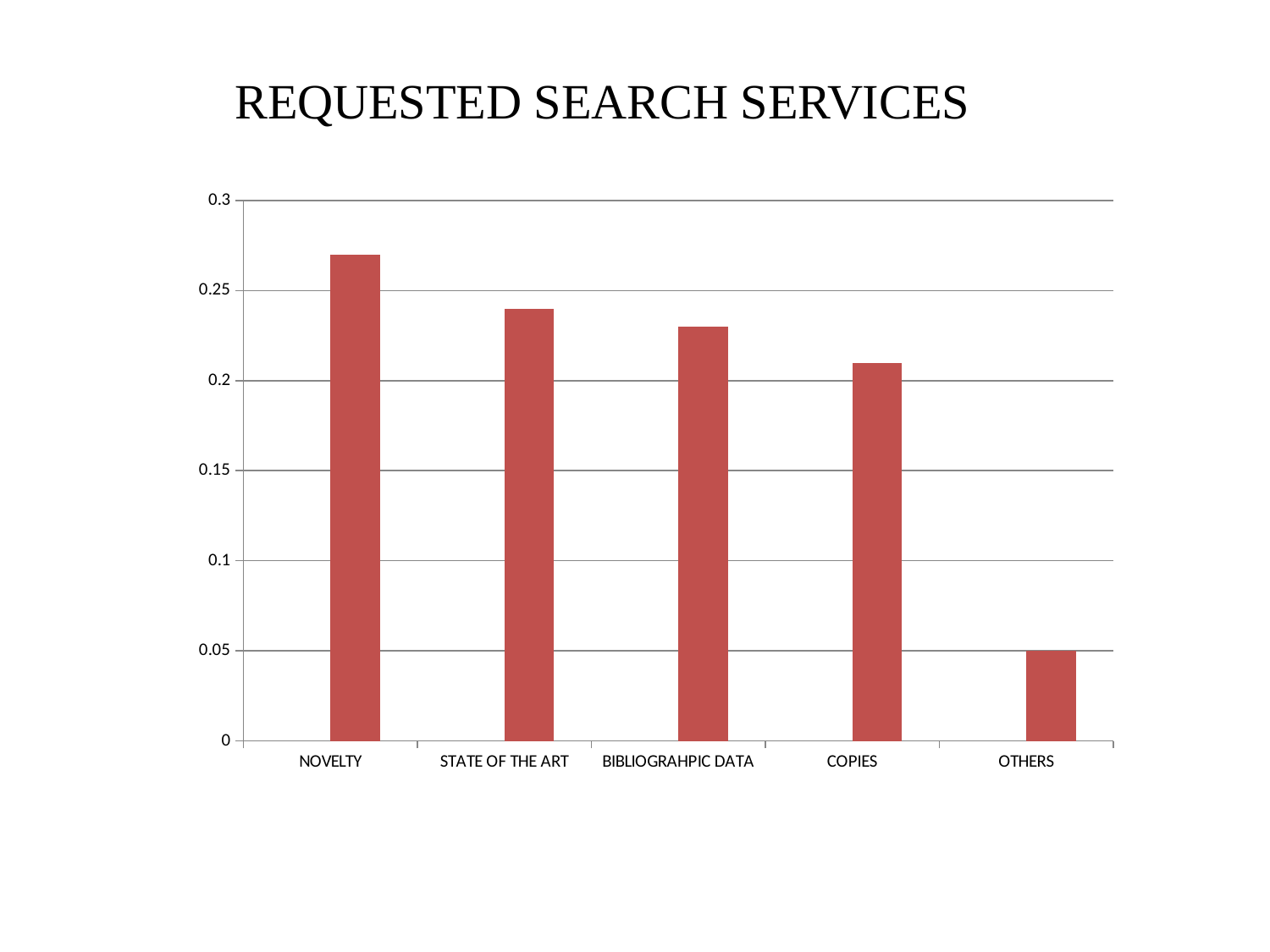
Which category has the lowest value? OTHERS Is the value for STATE OF THE ART greater or less than 0.25? less Is the value for COPIES greater or less than 0.25? less Do the values rise or fall moving from left to right along the x axis? fall What is the value for OTHERS? 0.05 Is the value for BIBLIOGRAHPIC DATA greater or less than 0.2? greater Which category has the highest value? NOVELTY What kind of chart is shown on the slide? bar chart How many categories are shown on the x axis? 5 What is the title of the chart? REQUESTED SEARCH SERVICES Which is larger, the value for NOVELTY or the value for COPIES? NOVELTY